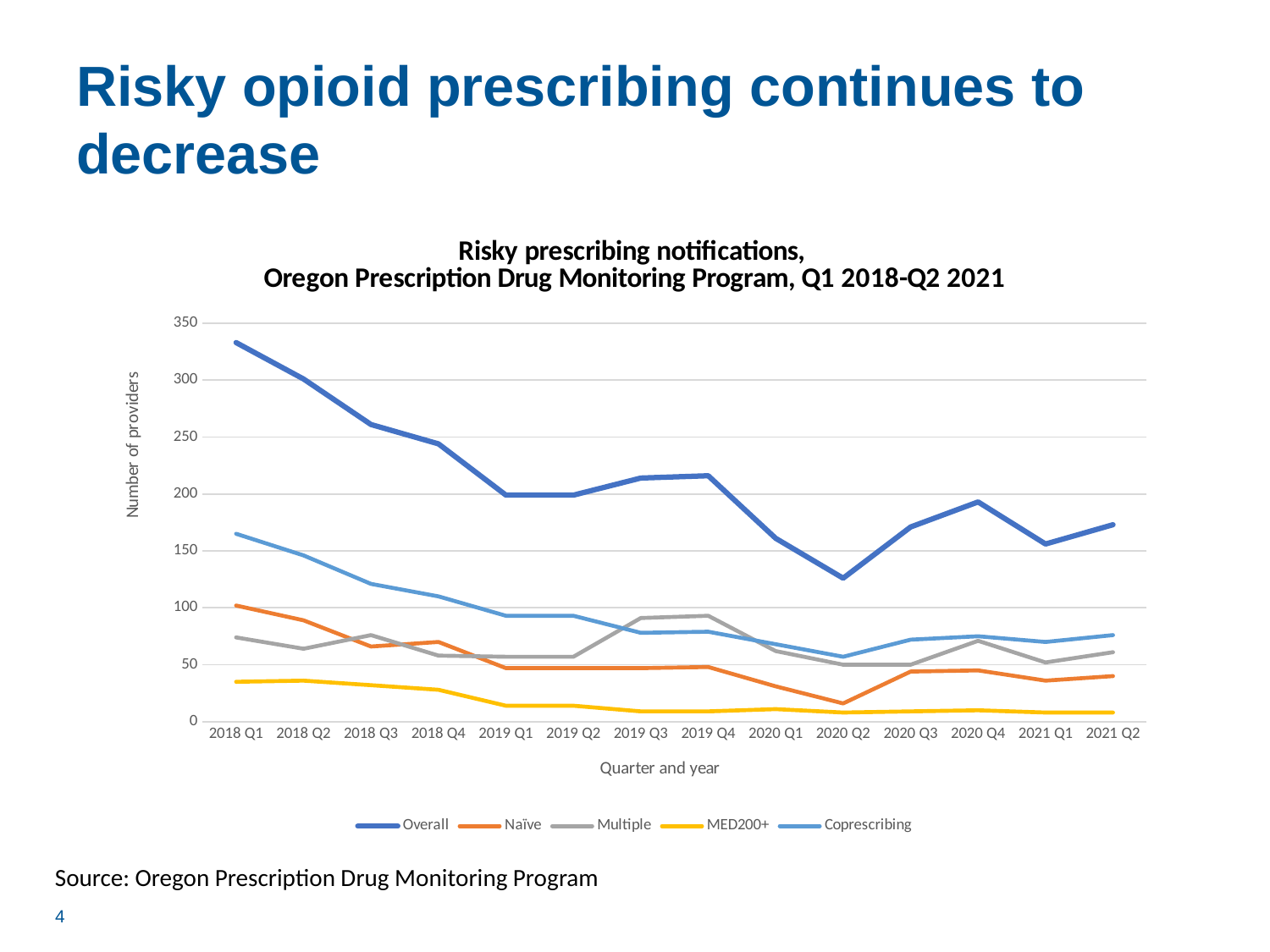
In which quarter is the Overall series at its highest? 2018 Q1 What kind of chart is shown on the slide? Line chart Is the Coprescribing value for 2018 Q1 greater or less than 150? greater How many series does the legend list? 5 In which quarter is the Overall series at its lowest? 2020 Q2 Does the Overall series rise or fall from 2018 Q1 to 2019 Q1? Fall How many quarters are plotted along the x axis? 14 In 2019 Q3, which is larger, the Multiple series or the Naïve series? Multiple Is the Overall value for 2020 Q2 greater or less than 150? less Is the Overall value for 2018 Q1 greater or less than 300? greater Which series has the lowest values across the whole period? MED200+ What is the title of the y axis? Number of providers